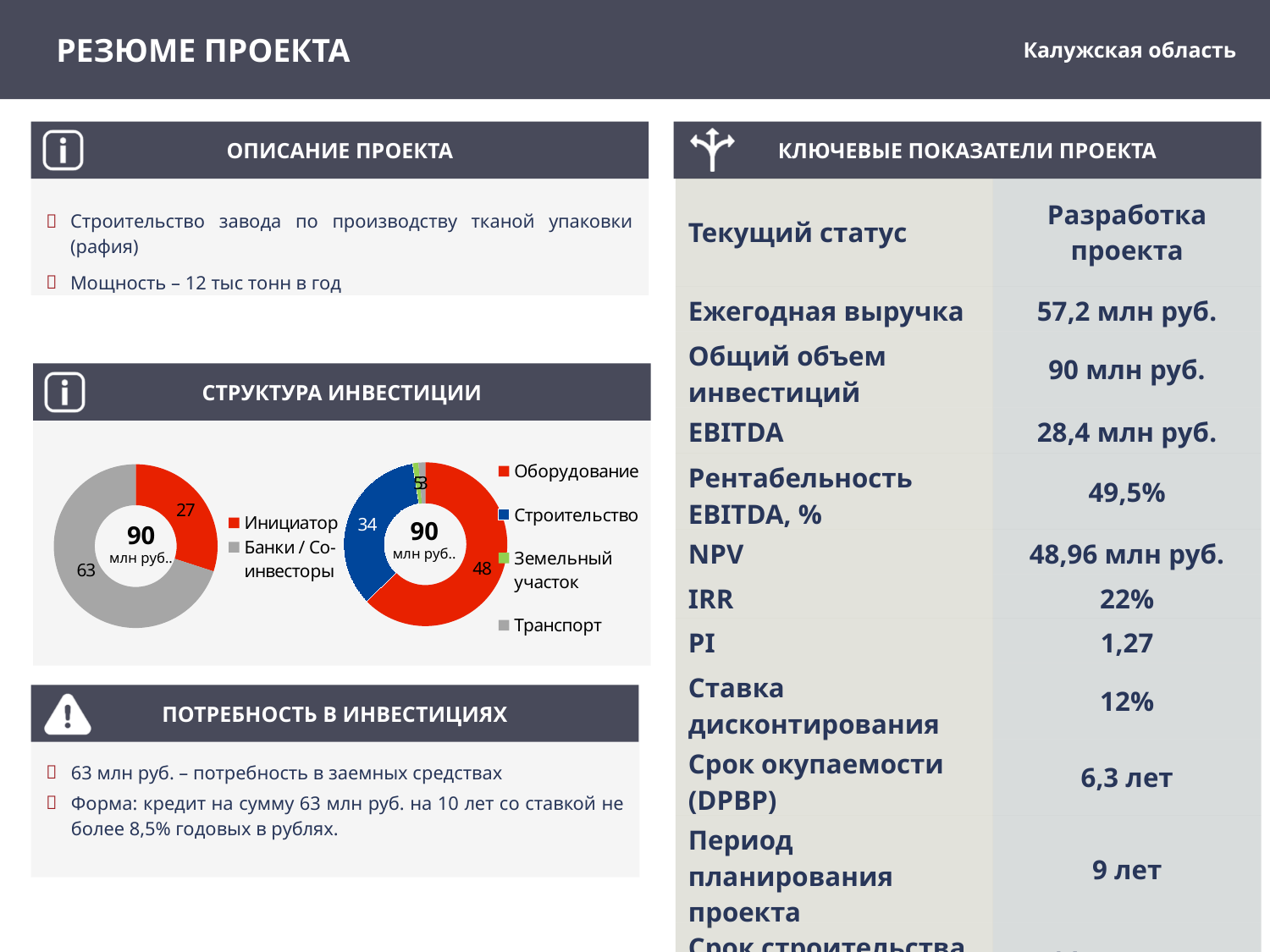
In the right donut chart under «Структура инвестиции», what is the value for «Строительство»? 34 In the right donut chart under «Структура инвестиции», which category has the largest value? Оборудование In the left donut chart under «Структура инвестиции», what share of the total does «Инициатор» represent? 30% In the left donut chart under «Структура инвестиции», what is the difference between «Банки / Со-инвесторы» and «Инициатор»? 36 In the left donut chart under «Структура инвестиции», what is the value for «Банки / Со-инвесторы»? 63 What type of chart is used in the «Структура инвестиции» section? Donut (pie) chart In the left donut chart under «Структура инвестиции», what is the value for «Инициатор»? 27 In the left donut chart under «Структура инвестиции», which category has the larger value? Банки / Со-инвесторы In the left donut chart under «Структура инвестиции», what total is shown in the centre of the donut? 90 млн руб. In the right donut chart under «Структура инвестиции», how many categories does the legend list? 4 In the right donut chart under «Структура инвестиции», what is the value for «Оборудование»? 48 In the right donut chart under «Структура инвестиции», is the value for «Оборудование» larger or smaller than the value for «Строительство»? larger